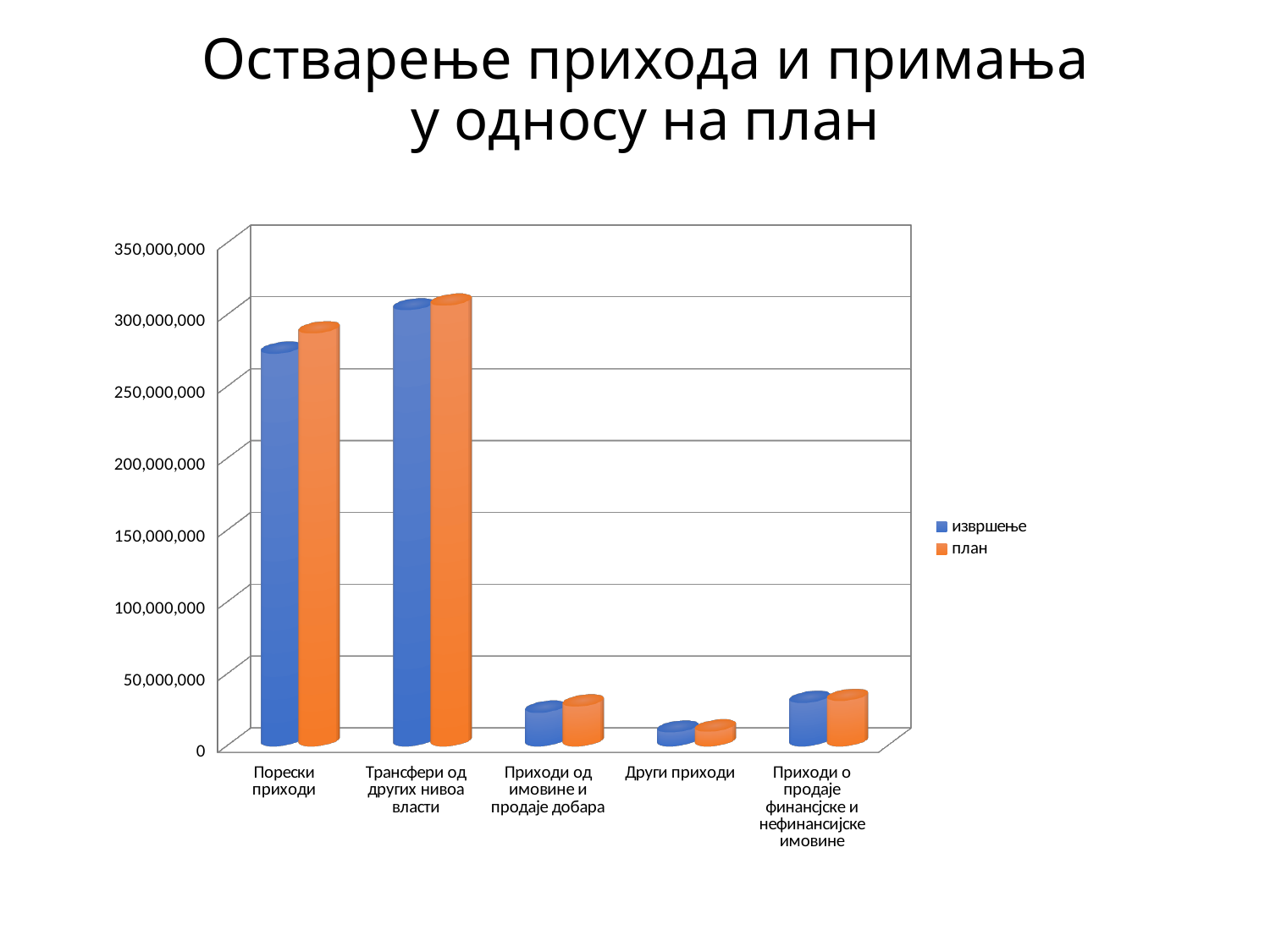
What kind of chart is shown on the slide? bar chart Is the извршење value for Други приходи greater or less than 50,000,000? less How many categories are shown on the x axis of the chart? 5 How many series does the chart legend list? 2 What is the title of the slide containing the chart? Остварење прихода и примања у односу на план Which category has the lowest value for the план series? Други приходи Which category has the highest value for the извршење series? Трансфери од других нивоа власти Is the план value for Трансфери од других нивоа власти greater or less than 350,000,000? less For Порески приходи, which is larger: извршење or план? план Which category has the lowest value for the извршење series? Други приходи What are the two series names listed in the chart legend? извршење and план Is the извршење value for Порески приходи greater or less than 250,000,000? greater